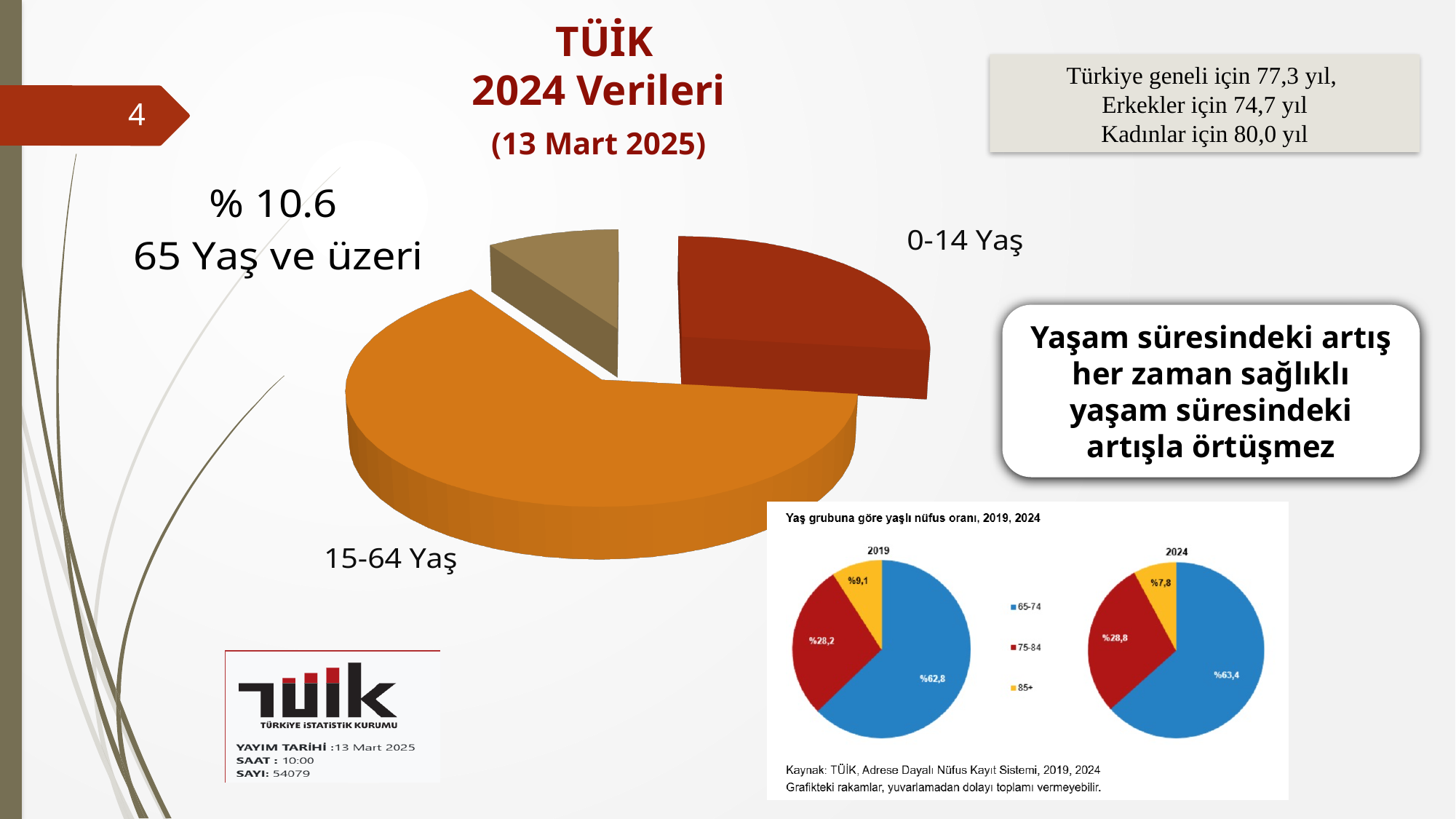
What kind of chart is the large chart in the centre of the slide? pie chart In the large pie chart, how many slices are there? 3 In the large pie chart, what share is shown for 65 Yaş ve üzeri? % 10.6 In the inset chart 'Yaş grubuna göre yaşlı nüfus oranı, 2019, 2024', what is the share of the 65-74 group in 2024? %63,4 In the inset chart 'Yaş grubuna göre yaşlı nüfus oranı, 2019, 2024', by how many percentage points did the 85+ share fall from 2019 to 2024? 1,3 In the inset chart 'Yaş grubuna göre yaşlı nüfus oranı, 2019, 2024', which age group has the largest share in the 2019 pie? 65-74 In the large pie chart, which age group has the smallest slice? 65 Yaş ve üzeri In the large pie chart, which slice is larger: 0-14 Yaş or 15-64 Yaş? 15-64 Yaş In the large pie chart, which age group has the largest slice? 15-64 Yaş In the inset chart 'Yaş grubuna göre yaşlı nüfus oranı, 2019, 2024', what is the share of the 85+ group in 2019? %9,1 In the inset chart 'Yaş grubuna göre yaşlı nüfus oranı, 2019, 2024', what is the share of the 75-84 group in 2024? %28,8 In the inset chart 'Yaş grubuna göre yaşlı nüfus oranı, 2019, 2024', how many age groups does the legend list? 3